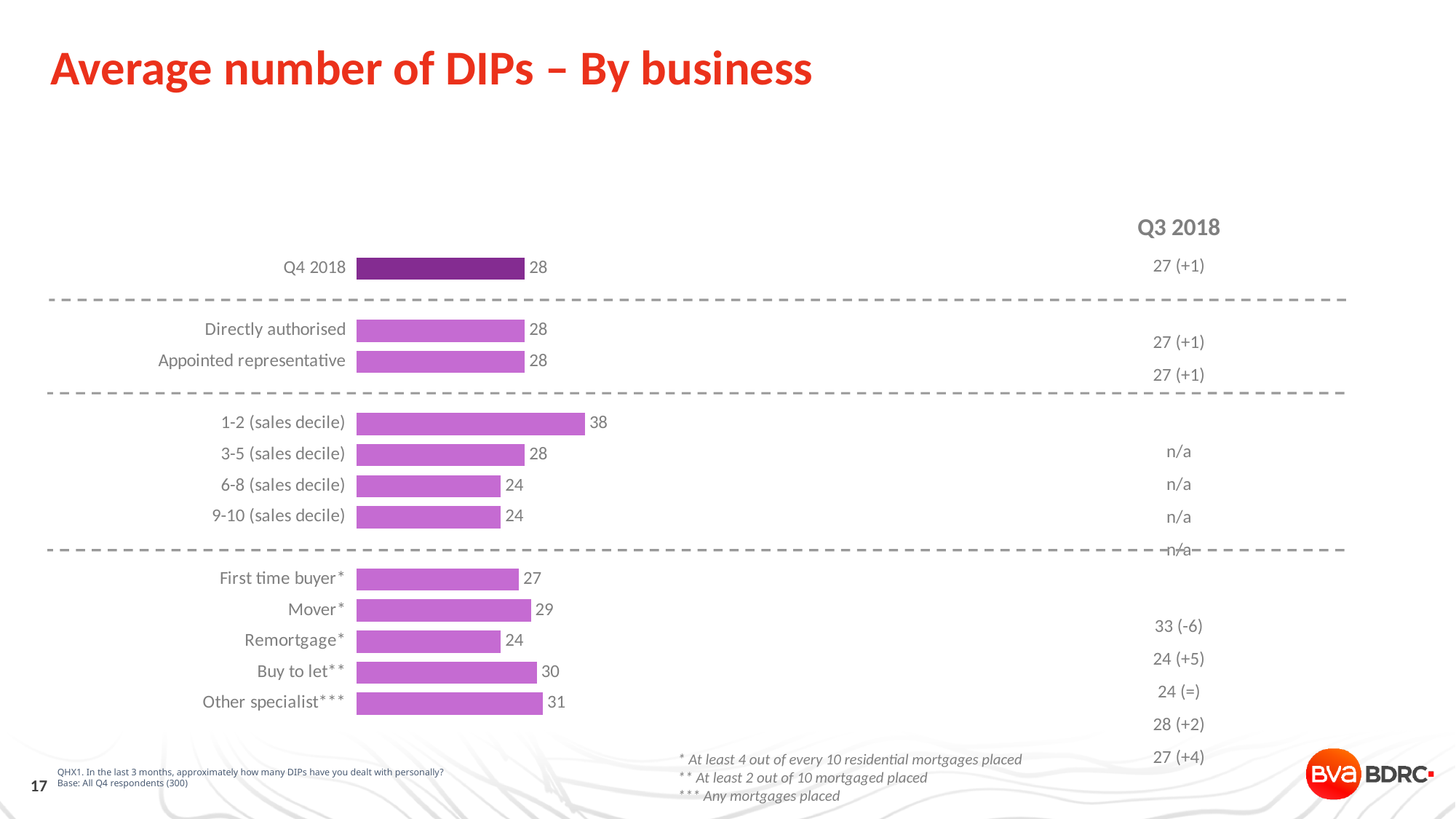
What is the difference between the values for Mover and Remortgage? 5 What is the Q3 2018 value shown for Q4 2018 overall? 27 (+1) What is the value for Other specialist? 31 What is the difference between the values for 1-2 (sales decile) and 3-5 (sales decile)? 10 How many bars are plotted on the chart? 12 Which category has the highest value? 1-2 (sales decile) What is the value for Remortgage? 24 Which is larger, the value for Buy to let or the value for First time buyer? Buy to let What kind of chart is shown? Bar chart What is the value for Q4 2018? 28 What is the title of the slide? Average number of DIPs – By business What is the value for 1-2 (sales decile)? 38